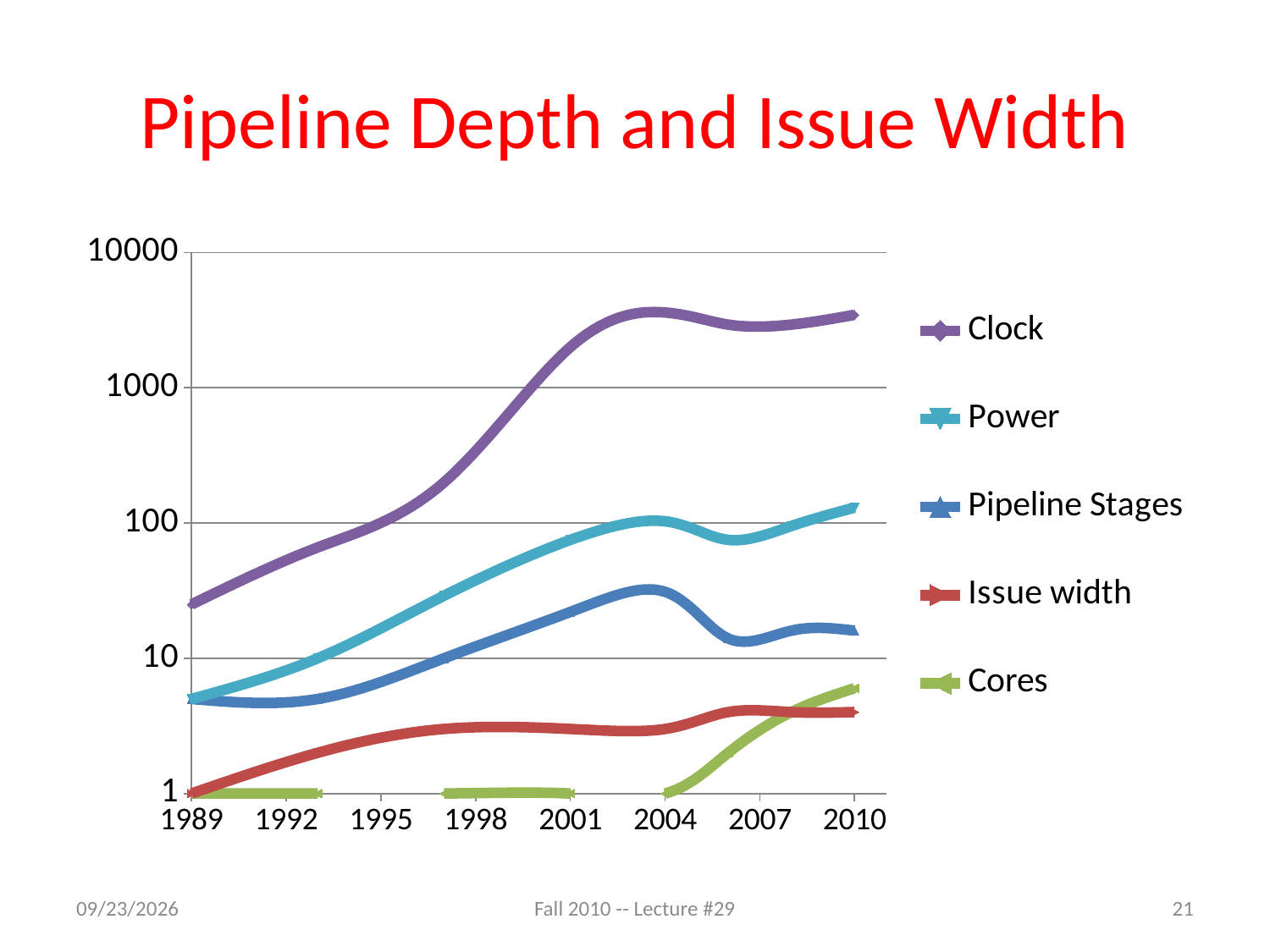
Is the value for Clock in 1989 greater or less than 100? less How many series does the legend list? 5 Is the value for Pipeline Stages in 2010 greater or less than 10? greater Is the value for Clock in 2010 greater or less than 1000? greater Which is larger in 2010, Clock or Power? Clock What is the title of the slide containing the chart? Pipeline Depth and Issue Width Does the Clock series rise or fall between 1989 and 2004? rise What is the value for Cores in 1989? 1 What kind of chart is shown on the slide? line chart What are the series listed in the legend? Clock, Power, Pipeline Stages, Issue width, Cores Which series has the highest value in 2010? Clock